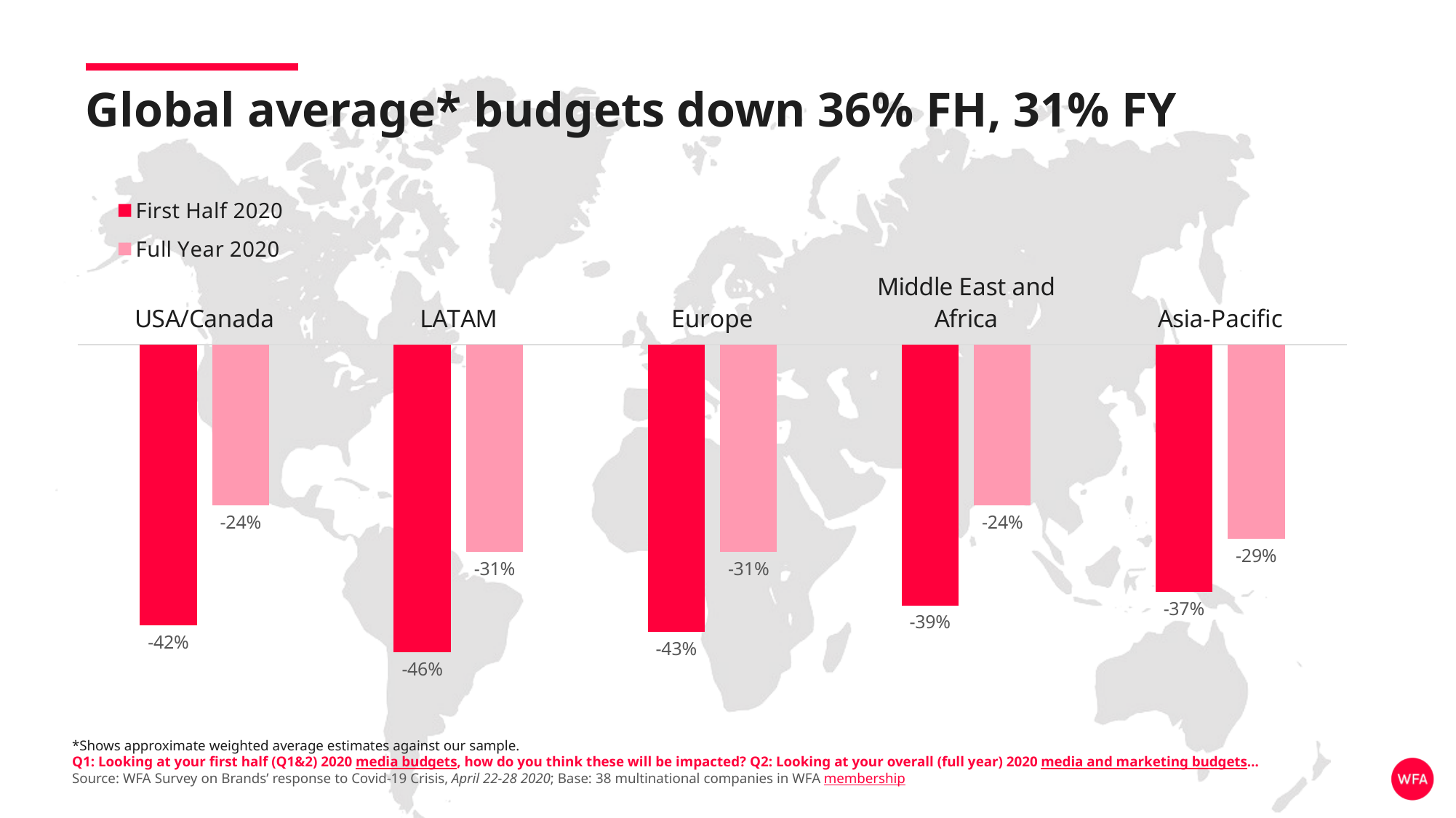
How many series does the legend list? 2 What is the First Half 2020 value for LATAM? -46% What kind of chart is shown on the slide? Bar chart Which region has the lowest (most negative) First Half 2020 value? LATAM By how many percentage points does the First Half 2020 value for Europe differ from its Full Year 2020 value? 12 percentage points What is the Full Year 2020 value for USA/Canada? -24% Which is lower, the First Half 2020 value for Europe or for Middle East and Africa? Europe By how many percentage points does the First Half 2020 value for USA/Canada differ from its Full Year 2020 value? 18 percentage points Which region has the highest (least negative) First Half 2020 value? Asia-Pacific What is the First Half 2020 value for Middle East and Africa? -39% How many regions are shown on the chart? 5 What is the Full Year 2020 value for Asia-Pacific? -29%